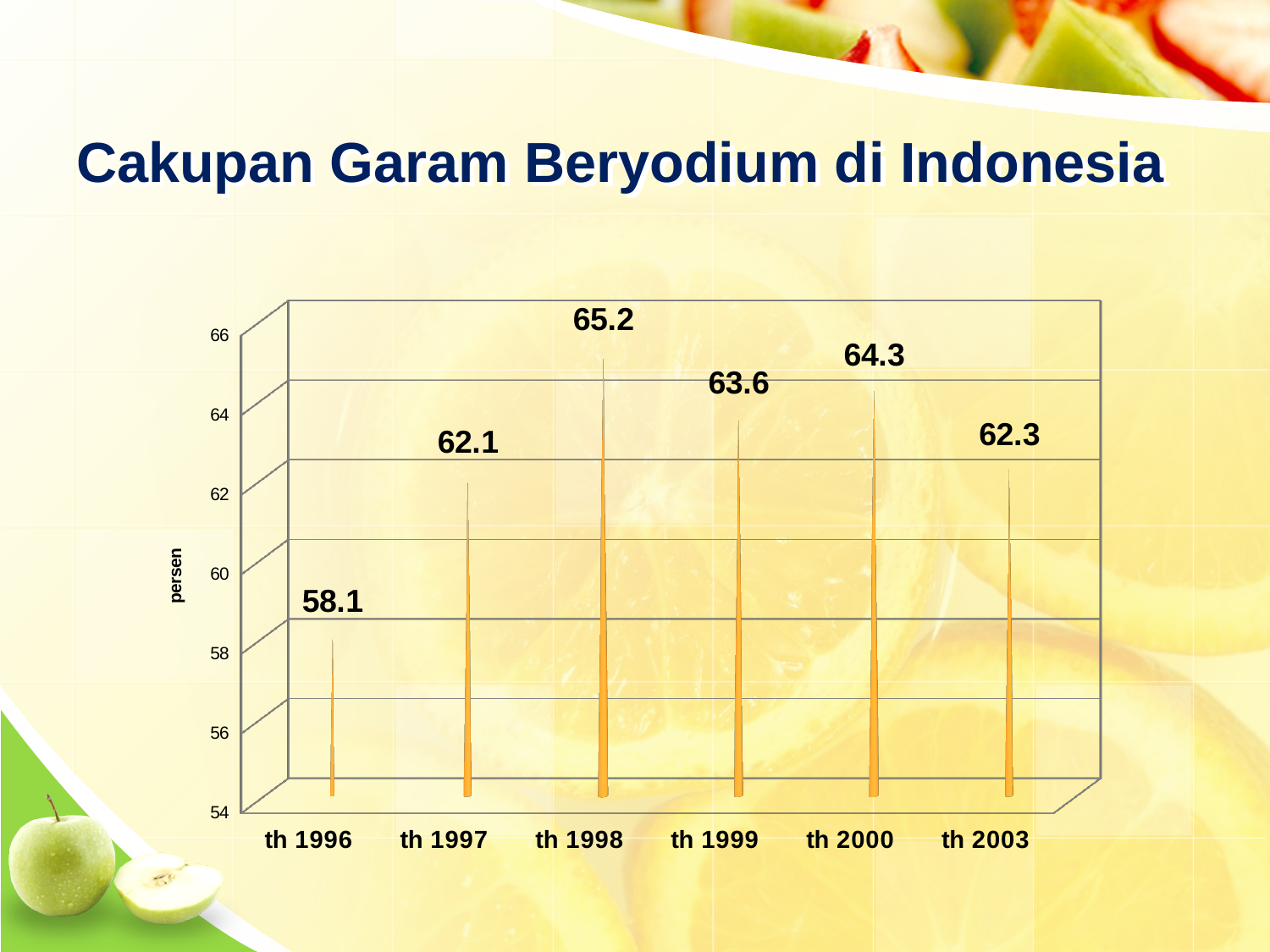
Which year has the lowest value? th 1996 What is the value for th 1998? 65.2 Which year has the highest value? th 1998 Is the value for th 1997 greater or less than 60? greater How many years are shown on the x axis? 6 What is the value for th 2003? 62.3 What is the title of the chart? Cakupan Garam Beryodium di Indonesia What is the value for th 1996? 58.1 What is the difference between the values for th 2000 and th 2003? 2.0 Which is larger, the value for th 1999 or the value for th 2000? th 2000 What kind of chart is shown on the slide? bar chart What is the difference between the values for th 1998 and th 1996? 7.1